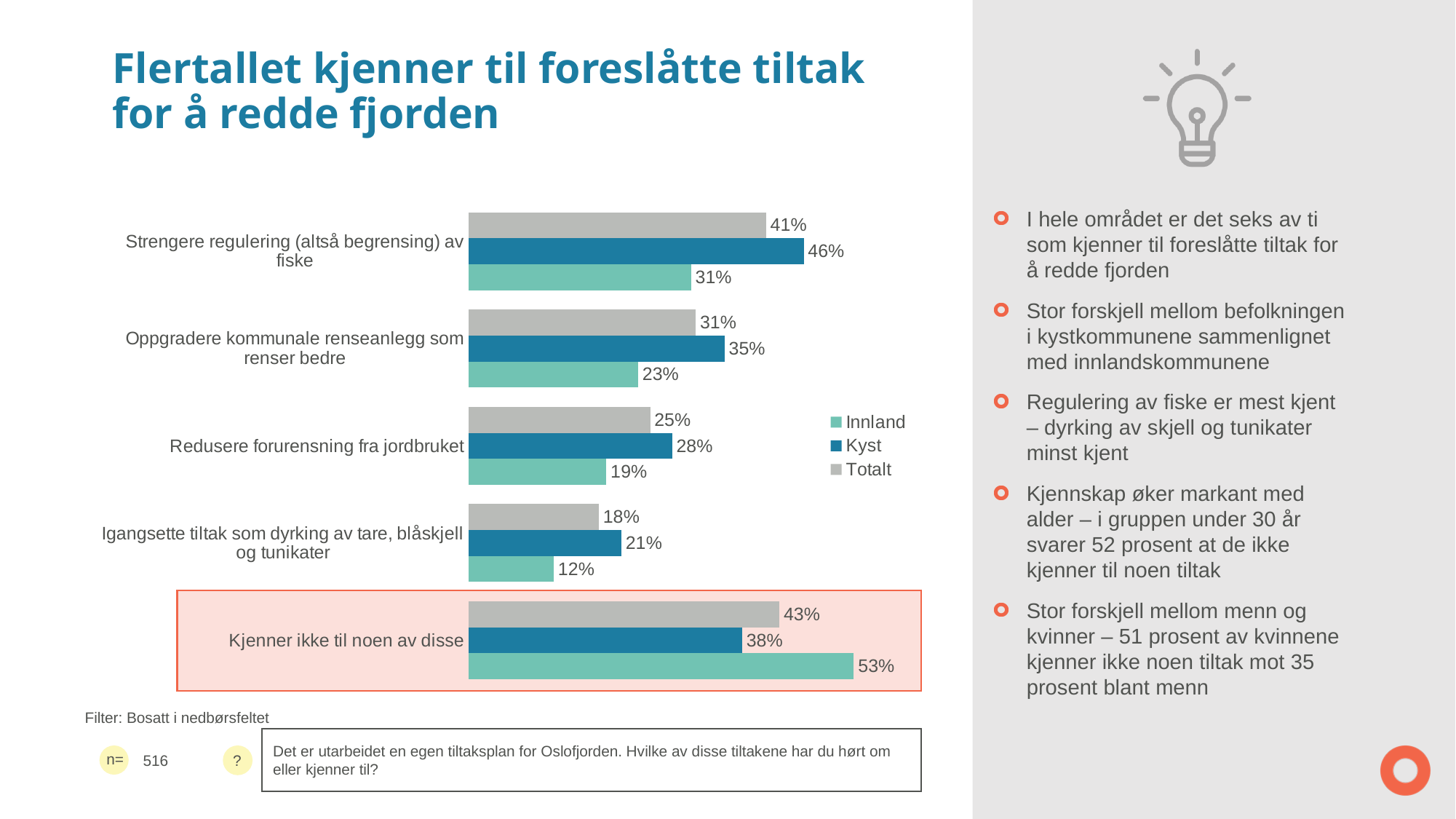
What is the difference between the Innland and Kyst values for "Kjenner ikke til noen av disse"? 15% Which is larger for "Redusere forurensning fra jordbruket": the Kyst value or the Innland value? Kyst What is the Kyst value for "Strengere regulering (altså begrensing) av fiske"? 46% What kind of chart is shown on the slide? Bar chart What is the Innland value for "Kjenner ikke til noen av disse"? 53% What is the Totalt value for "Redusere forurensning fra jordbruket"? 25% How many categories are shown in the chart? 5 How many series does the legend list? 3 What is the difference between the Kyst and Innland values for "Oppgradere kommunale renseanlegg som renser bedre"? 12% Which category is highlighted with a red outlined box in the chart? Kjenner ikke til noen av disse Which category has the highest Kyst value? Strengere regulering (altså begrensing) av fiske Which category has the lowest Innland value? Igangsette tiltak som dyrking av tare, blåskjell og tunikater